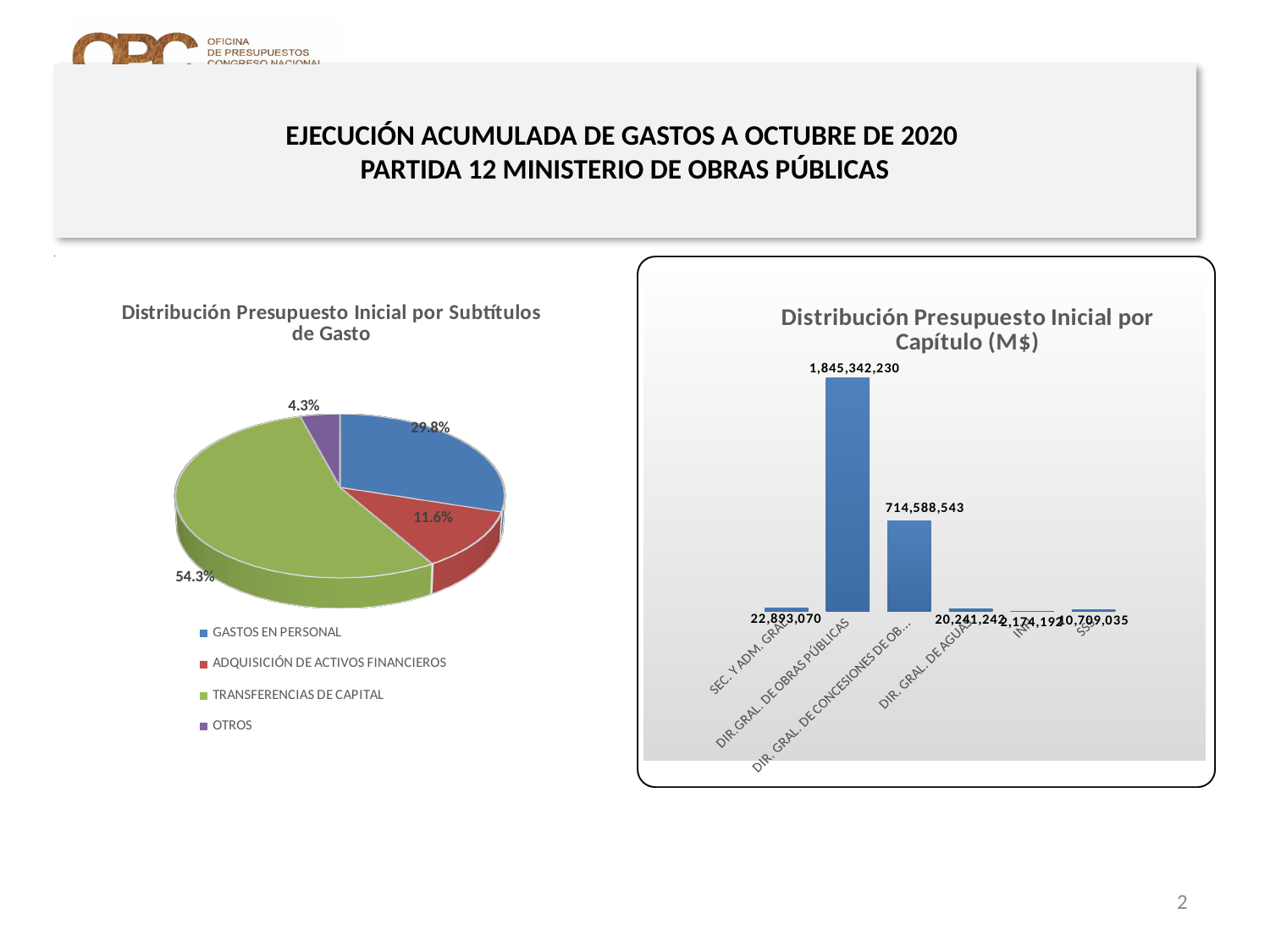
In the pie chart 'Distribución Presupuesto Inicial por Subtítulos de Gasto', which category has the largest share? TRANSFERENCIAS DE CAPITAL What kind of chart is 'Distribución Presupuesto Inicial por Subtítulos de Gasto'? Pie chart How many categories does the legend of the pie chart 'Distribución Presupuesto Inicial por Subtítulos de Gasto' list? 4 In the pie chart 'Distribución Presupuesto Inicial por Subtítulos de Gasto', what percentage is shown for GASTOS EN PERSONAL? 29.8% In the pie chart 'Distribución Presupuesto Inicial por Subtítulos de Gasto', what is the difference in percentage points between GASTOS EN PERSONAL and ADQUISICIÓN DE ACTIVOS FINANCIEROS? 18.2 In the bar chart 'Distribución Presupuesto Inicial por Capítulo (M$)', which chapter has the highest value? DIR.GRAL. DE OBRAS PÚBLICAS In the bar chart 'Distribución Presupuesto Inicial por Capítulo (M$)', what is the value for DIR.GRAL. DE OBRAS PÚBLICAS? 1,845,342,230 In the pie chart 'Distribución Presupuesto Inicial por Subtítulos de Gasto', which category has the smallest share? OTROS In the bar chart 'Distribución Presupuesto Inicial por Capítulo (M$)', which is larger: SEC. Y ADM. GRAL. or DIR. GRAL. DE AGUAS? SEC. Y ADM. GRAL. How many bars are plotted in the bar chart 'Distribución Presupuesto Inicial por Capítulo (M$)'? 6 In the pie chart 'Distribución Presupuesto Inicial por Subtítulos de Gasto', what share does TRANSFERENCIAS DE CAPITAL have? 54.3% In the bar chart 'Distribución Presupuesto Inicial por Capítulo (M$)', what is the value for SEC. Y ADM. GRAL.? 22,893,070